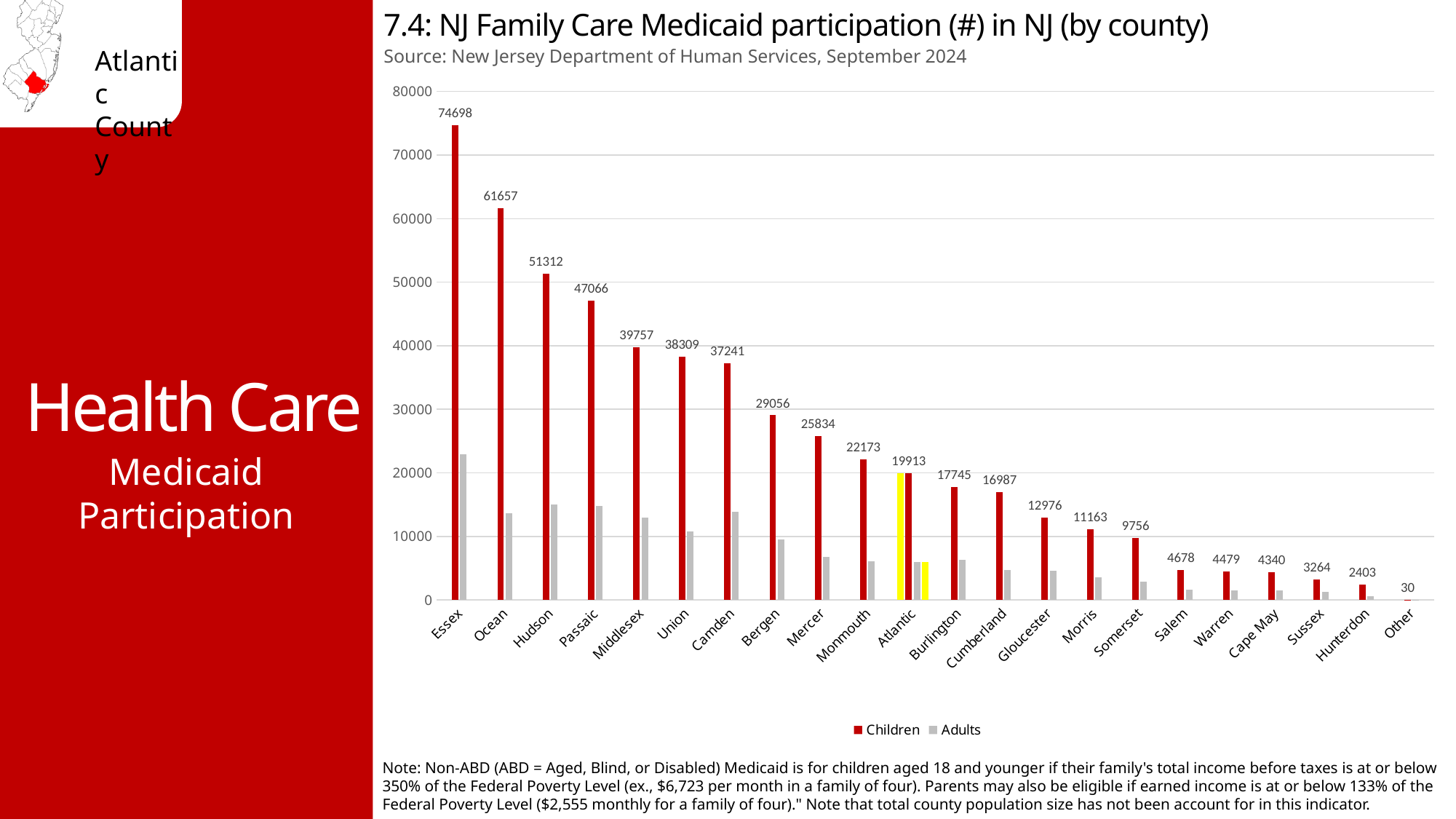
How many series does the legend list? 2 Is the Adults value for Essex greater or less than 20000? greater What is the Children value for Hunterdon? 2403 Which category has the lowest Children value? Other What is the difference between the Children values for Essex and Ocean? 13041 Which has a larger Children value, Bergen or Mercer? Bergen Which county has the highest Children value? Essex What kind of chart is shown? Bar chart How many categories are shown on the x axis? 22 Is the Adults value for Atlantic greater or less than 10000? less What is the Children value for Essex? 74698 What is the Children value for Atlantic? 19913